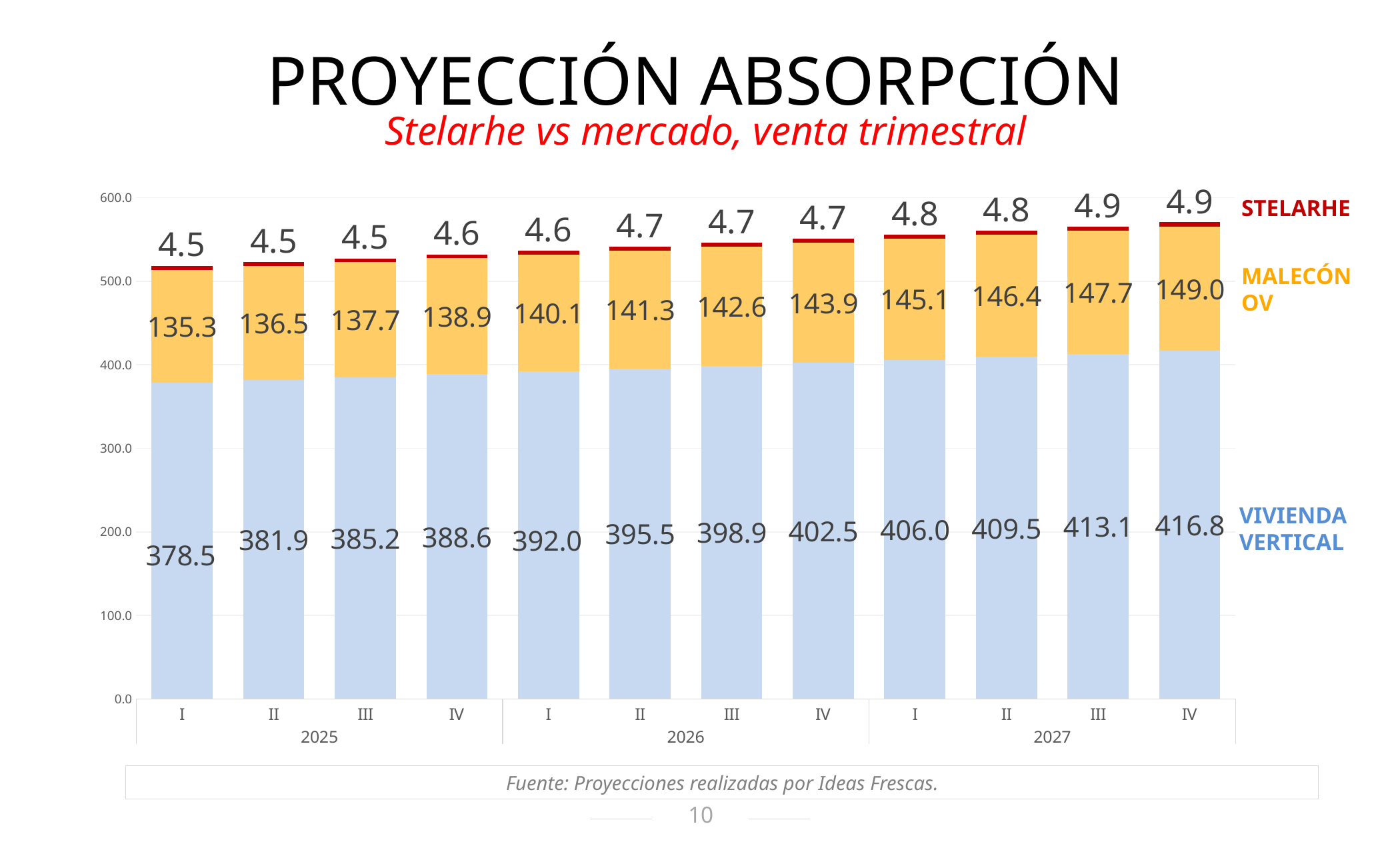
How many series does the chart show? 3 What is the difference between the VIVIENDA VERTICAL values for quarter IV of 2027 and quarter I of 2025? 38.3 What is the VIVIENDA VERTICAL value for quarter I of 2025? 378.5 What is the total of the stacked bar for quarter I of 2025? 518.3 What is the MALECÓN OV value for quarter IV of 2027? 149.0 How many quarters (bars) are shown on the chart? 12 What kind of chart is shown on the slide? Stacked bar chart Is the VIVIENDA VERTICAL value for quarter I of 2026 greater or less than 300.0? greater Which is larger: the MALECÓN OV value for quarter III of 2026 or for quarter I of 2027? I 2027 In which quarter is the VIVIENDA VERTICAL value highest? IV 2027 What is the STELARHE value for quarter II of 2026? 4.7 In which quarter is the MALECÓN OV value lowest? I 2025